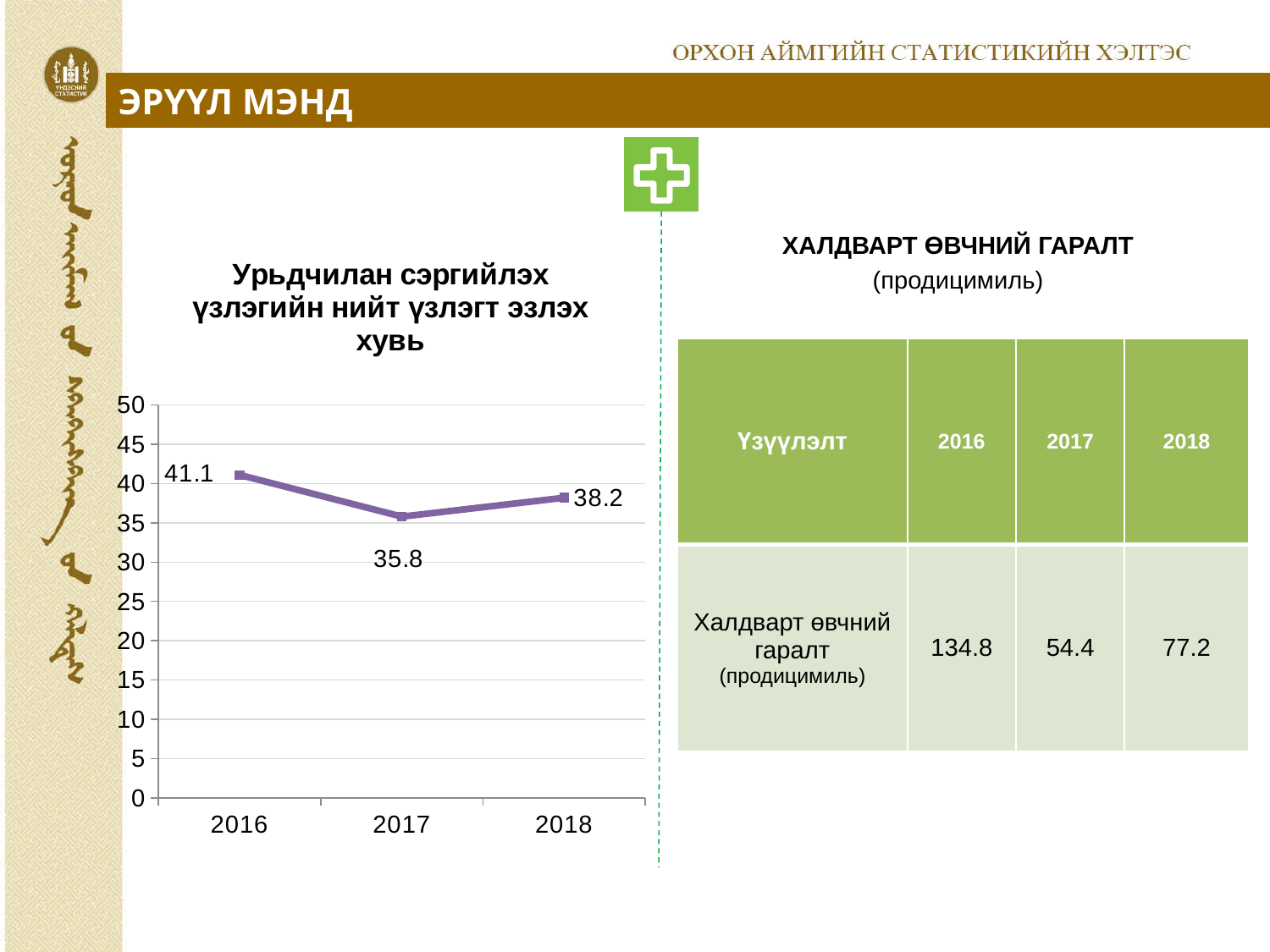
What is the value for 2018 in the line chart? 38.2 How many data points are plotted in the line chart? 3 Which year has the highest value in the line chart? 2016 Which year has the lowest value in the line chart? 2017 What type of chart is shown on the slide? line chart What is the value for 2017 in the line chart? 35.8 What is the title of the line chart? Урьдчилан сэргийлэх үзлэгийн нийт үзлэгт эзлэх хувь What is the difference between the 2018 and 2017 values in the line chart? 2.4 What is the value for 2016 in the line chart? 41.1 What is the difference between the 2016 and 2017 values in the line chart? 5.3 Is the value for 2017 in the line chart greater or less than 40? less Which is larger in the line chart, the value for 2016 or the value for 2018? 2016